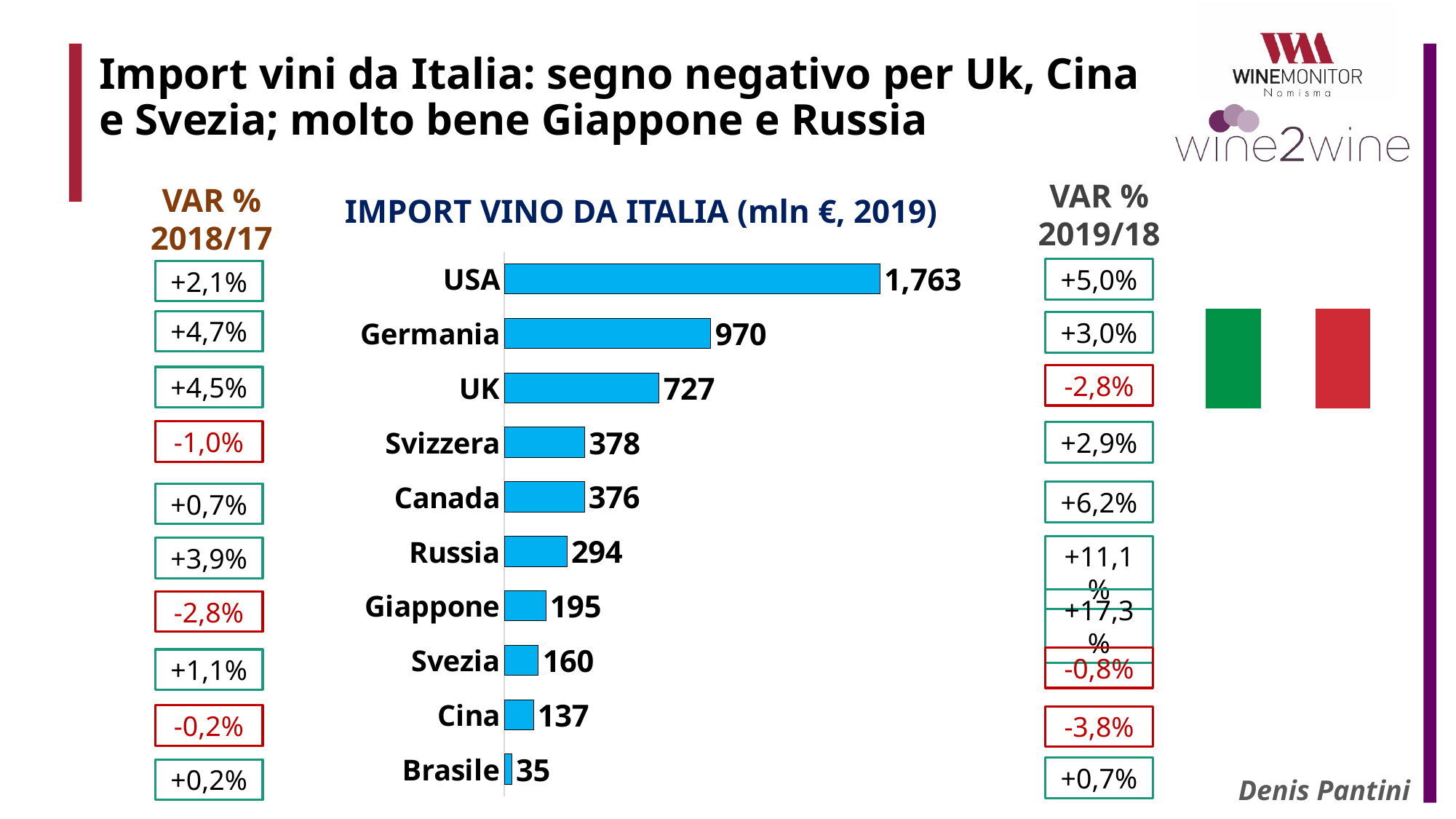
Which country has the highest import value in the chart? USA What kind of chart is shown on the slide? Bar chart What is the title of the chart? IMPORT VINO DA ITALIA (mln €, 2019) What is the import value for Brasile? 35 Which country has the lowest import value in the chart? Brasile What is the import value for Germania? 970 How many countries are shown in the chart? 10 What is the import value for USA in the chart? 1,763 What is the difference between the import values of USA and Germania? 793 Which has a larger import value, Russia or Svezia? Russia What is the difference between the import values of UK and Svizzera? 349 What is the import value for Giappone? 195